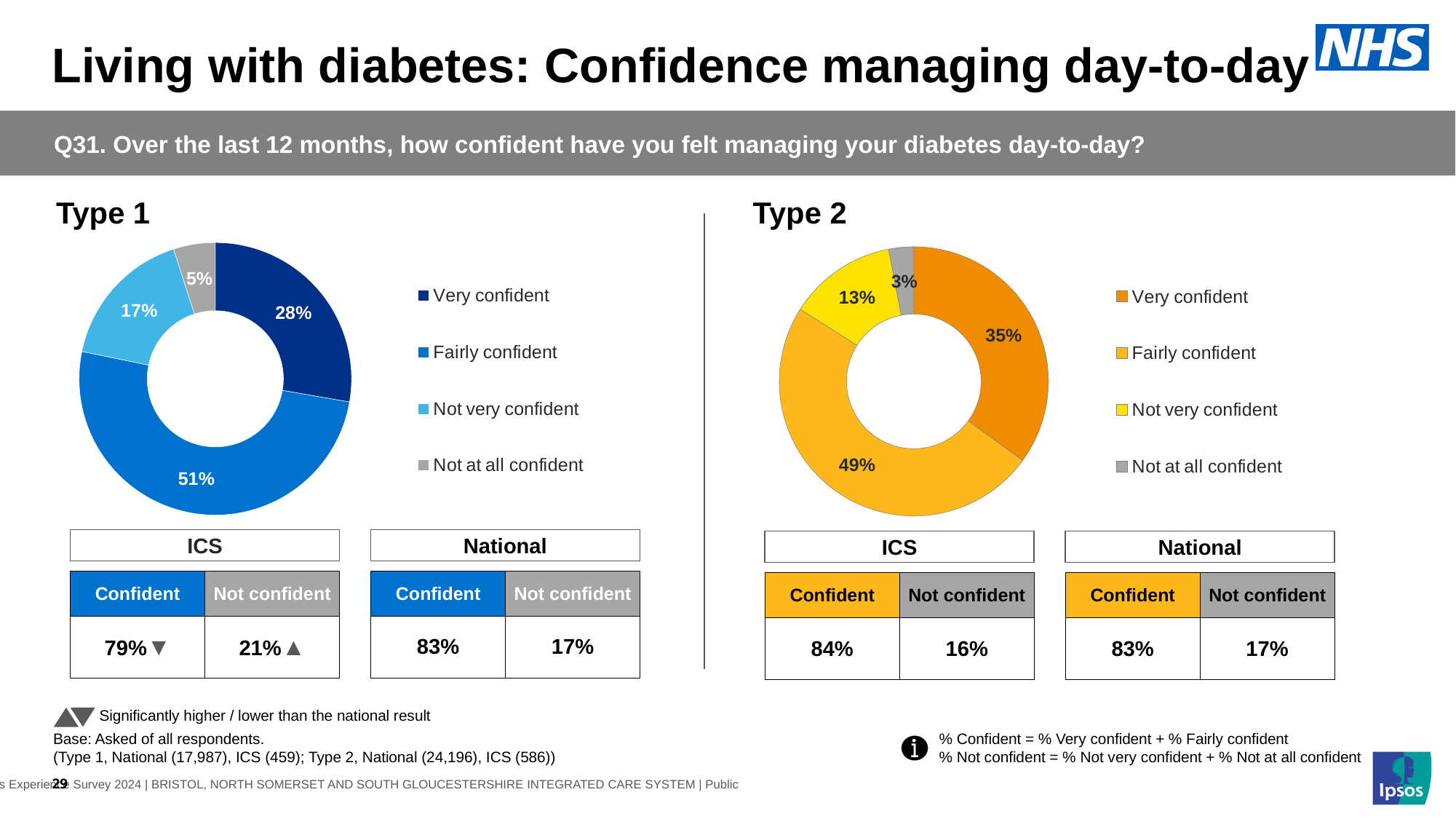
In the Type 1 chart, which category has the largest share? Fairly confident In the Type 1 chart, what is the difference between the Fairly confident and Very confident percentages? 23% In the Type 2 chart, which category has the smallest share? Not at all confident In the Type 2 chart, what percentage of respondents were Very confident? 35% How many categories does the Type 1 chart show? 4 In the Type 2 chart, what is the difference between the Not very confident and Not at all confident percentages? 10% In the Type 1 chart, what percentage of respondents were Not at all confident? 5% In the Type 1 chart, what percentage of respondents were Fairly confident? 51% In the Type 1 chart, what colour is the Not very confident segment? Light blue In the Type 2 chart, what percentage of respondents were Not very confident? 13% Is the Very confident share larger in the Type 1 chart or the Type 2 chart? Type 2 What kind of chart is used for Type 2? Doughnut chart